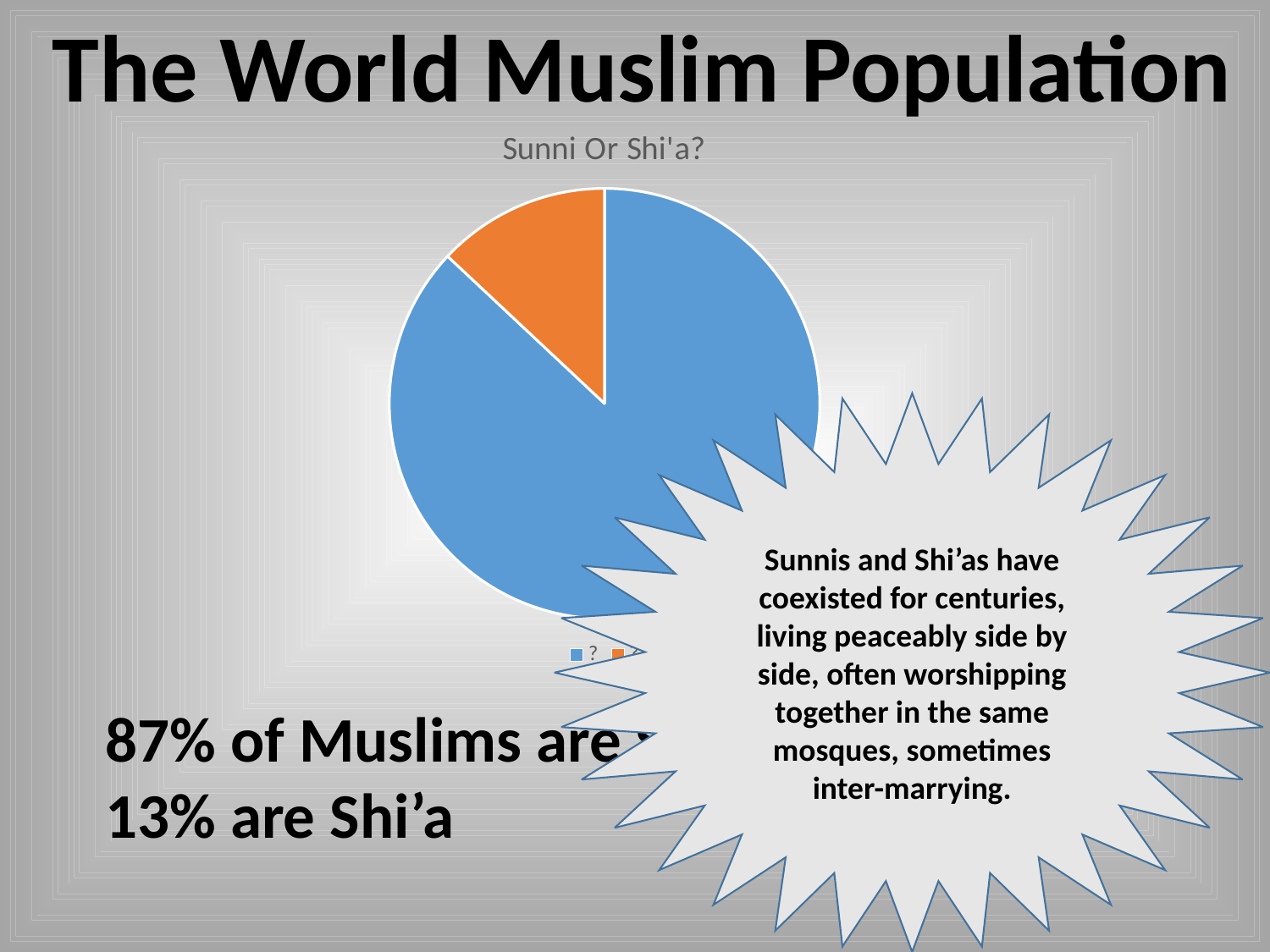
Which slice of the pie chart is larger, the blue one or the orange one? blue What kind of chart is shown on the slide? pie chart Is the orange slice's share of the pie greater or less than 25%? less Which colour slice is the smallest in the pie chart? orange Is the blue slice's share of the pie greater or less than 50%? greater What colour is the larger slice of the pie chart? blue According to the text on the slide, what percentage is given for the larger group of Muslims? 87% How many slices does the pie chart have? 2 How many entries does the pie chart's legend list? 2 According to the text on the slide, what percentage of Muslims are Shi'a? 13% What is the difference between the two percentages stated on the slide (87% and 13%)? 74% What is the title of the pie chart? Sunni Or Shi'a?